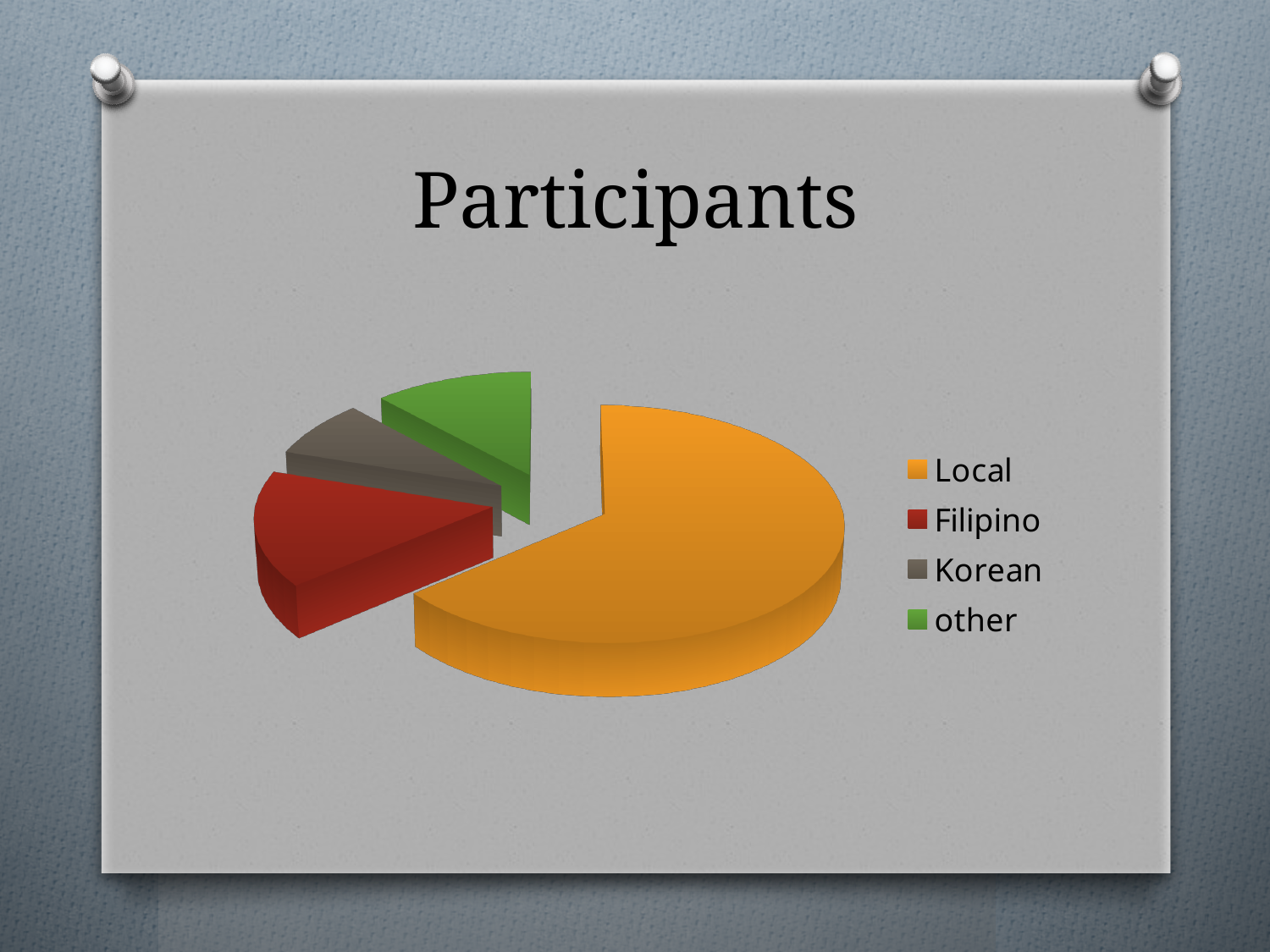
How many entries does the legend list? 4 Which is larger, the Filipino slice or the Korean slice? Filipino What is the title of the slide? Participants What kind of chart is shown on the slide? pie chart Which category has the largest slice of the pie? Local Which is larger, the Local slice or the Filipino slice? Local How many slices does the pie chart have? 4 Which is larger, the Filipino slice or the other slice? Filipino What colour is the Local slice in the pie chart? orange